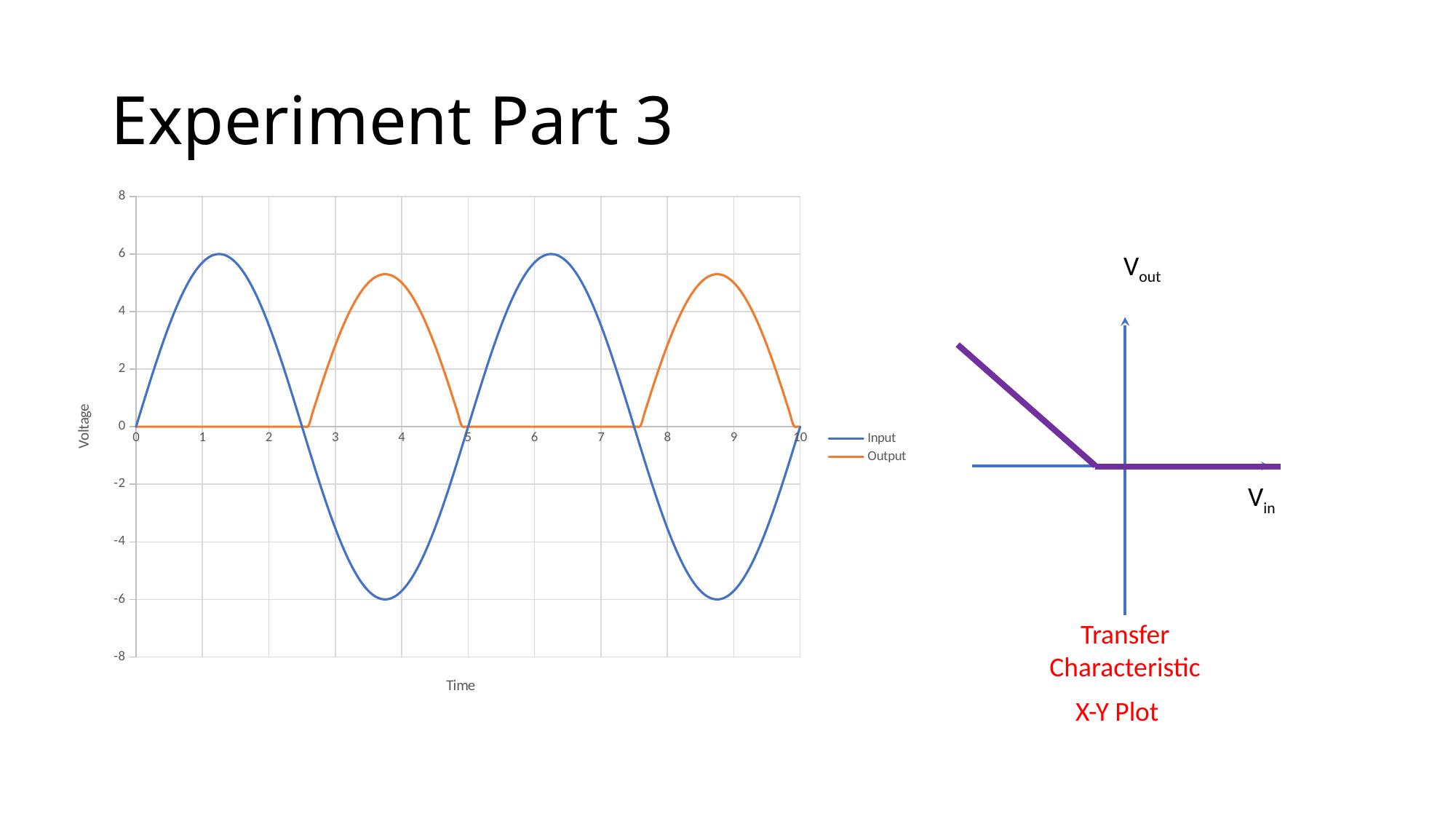
In the left chart, what is the peak value reached by the Input series? 6 What is the title of the horizontal axis of the left chart? Time In the left chart, is the peak value of the Output series greater or less than 4? greater How many series does the legend of the left chart list? 2 In the left chart, which series reaches the higher peak, Input or Output? Input In the left chart, what is the value of the Output series at time 1? 0 In the left chart, what is the lowest value reached by the Input series? -6 In the left chart, is the peak value of the Output series greater or less than 6? less What kind of chart is shown on the left of the slide? line chart In the left chart, what is the lowest value reached by the Output series? 0 In the left chart, does the Input series rise or fall between time 0 and time 1? rise What are the two series named in the legend of the left chart? Input and Output